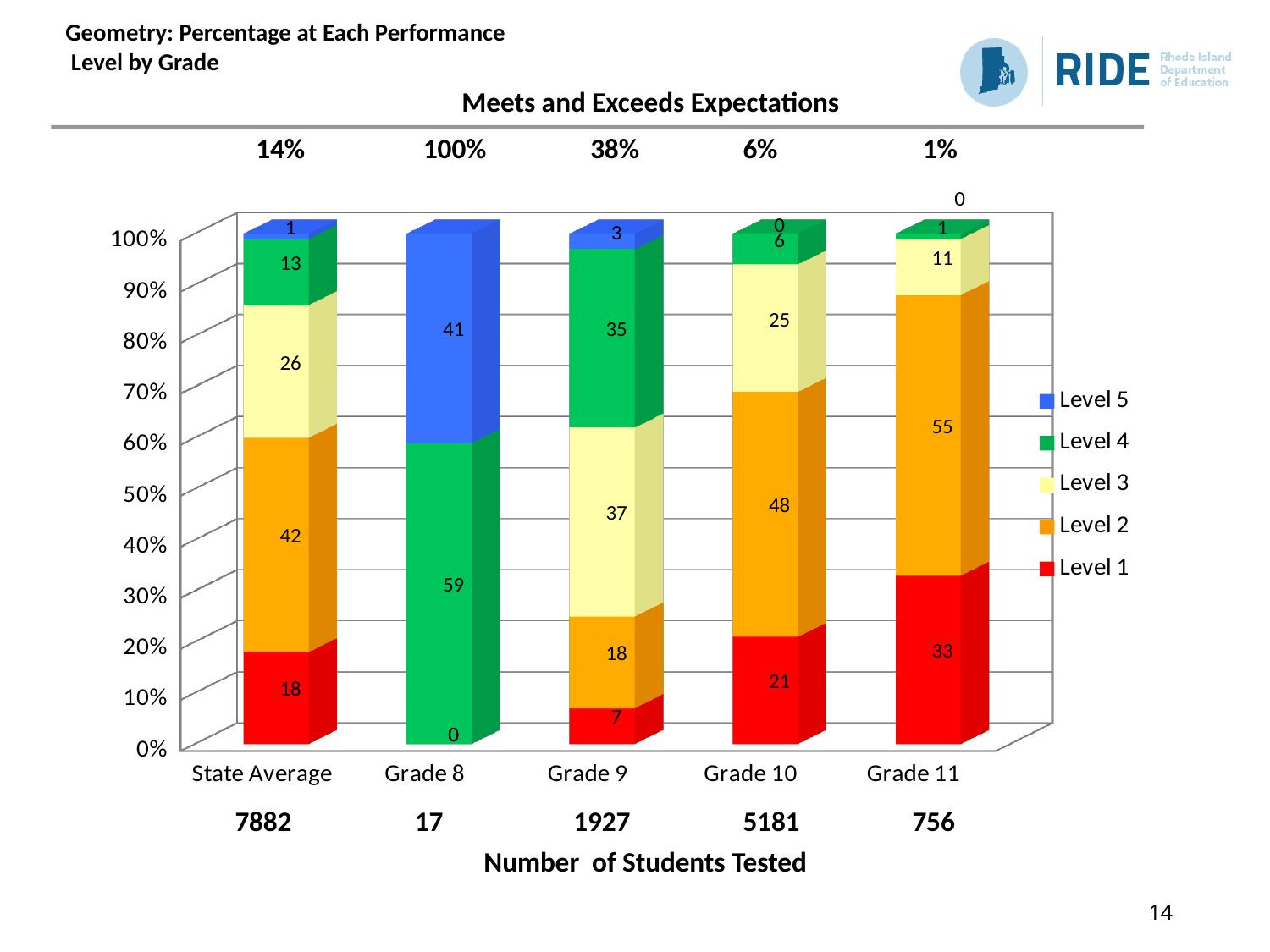
Which category has the highest Level 1 value? Grade 11 Which is larger, the Level 3 value for Grade 9 or the Level 3 value for Grade 10? Grade 9 What is the Level 3 value for State Average? 26 What is the Level 1 value for Grade 11? 33 What is the Level 2 value for Grade 10? 48 How many categories are shown on the x axis? 5 What kind of chart is shown on the slide? Stacked bar chart What is the Meets and Exceeds Expectations percentage shown above Grade 9? 38% What is the Level 4 value for Grade 8? 59 Which category has the lowest Level 2 value among those with a printed Level 2 label? Grade 9 What is the difference between the Level 2 values for Grade 11 and Grade 9? 37 How many series does the legend list? 5